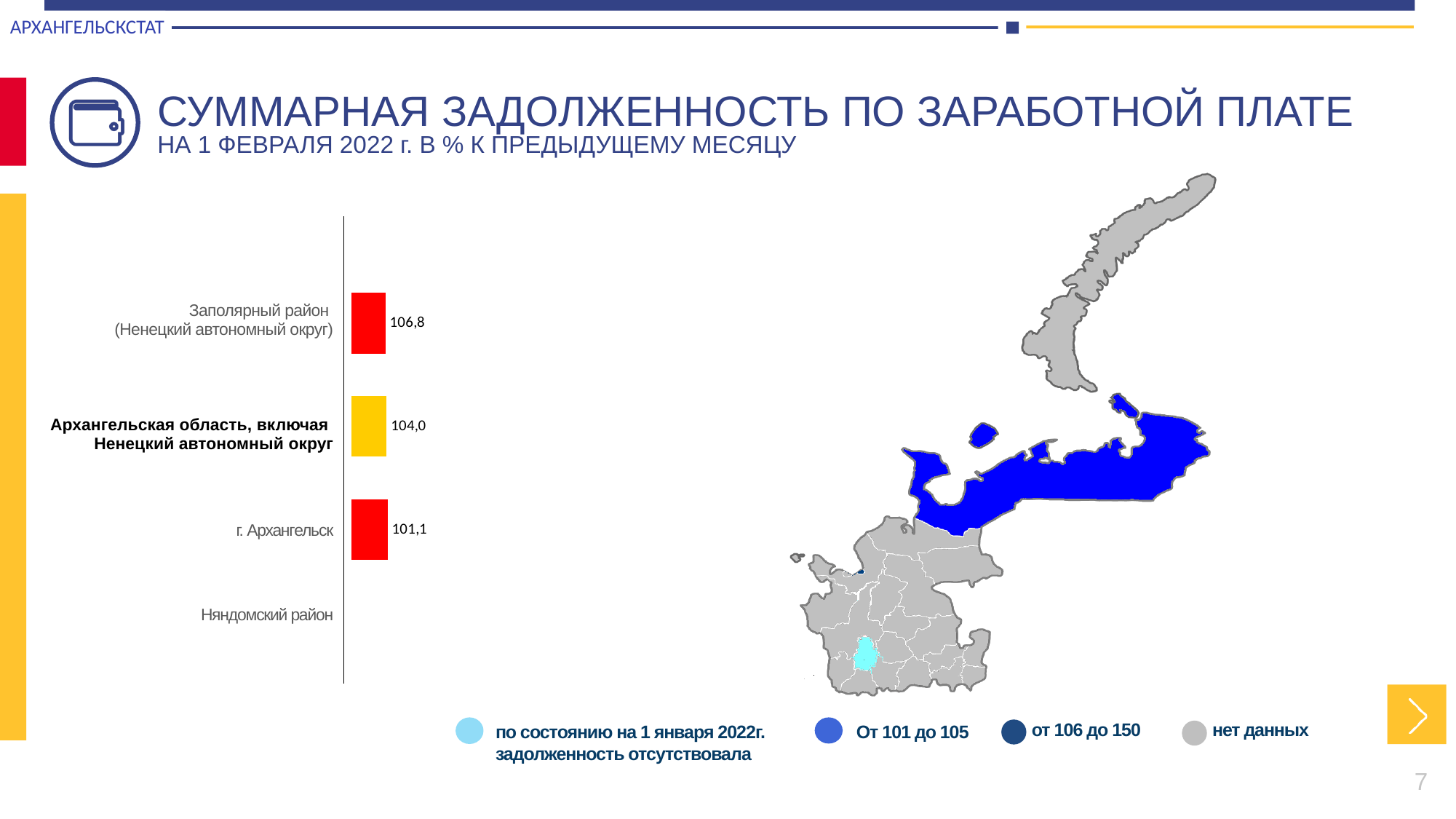
Which category on the bar chart has no bar or value shown? Няндомский район What kind of chart is shown on the left of the slide? Bar chart What is the difference between the values for Заполярный район (Ненецкий автономный округ) and г. Архангельск? 5,7 What colour is the bar for Архангельская область, включая Ненецкий автономный округ? Yellow How many category labels are listed on the bar chart's axis? 4 Among the categories with a labelled bar, which has the lowest value? г. Архангельск Which is larger: the value for Заполярный район (Ненецкий автономный округ) or for Архангельская область, включая Ненецкий автономный округ? Заполярный район (Ненецкий автономный округ) What is the value shown for г. Архангельск in the bar chart? 101,1 Which category in the bar chart has the highest value? Заполярный район (Ненецкий автономный округ) What is the difference between the values for Архангельская область, включая Ненецкий автономный округ and г. Архангельск? 2,9 What is the value shown for Заполярный район (Ненецкий автономный округ) in the bar chart? 106,8 What is the value shown for Архангельская область, включая Ненецкий автономный округ in the bar chart? 104,0